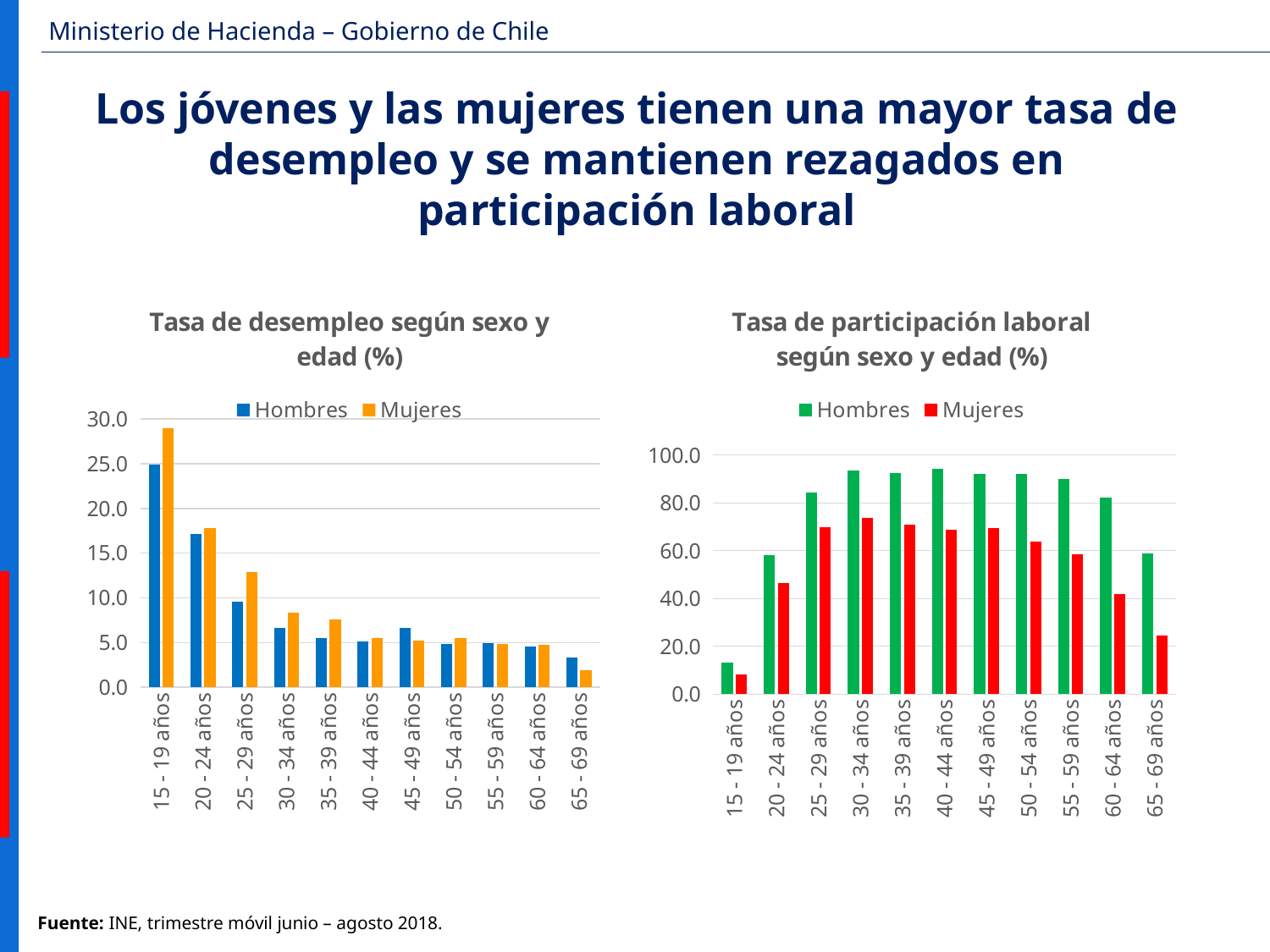
How many series does the legend list in the chart 'Tasa de participación laboral según sexo y edad (%)'? 2 In the chart 'Tasa de participación laboral según sexo y edad (%)', which is larger for the 50 - 54 años group, Hombres or Mujeres? Hombres How many age groups are shown on the x axis of the chart 'Tasa de desempleo según sexo y edad (%)'? 11 In the chart 'Tasa de desempleo según sexo y edad (%)', which is larger for the 25 - 29 años group, Hombres or Mujeres? Mujeres What kind of chart is 'Tasa de participación laboral según sexo y edad (%)'? Bar chart In the chart 'Tasa de participación laboral según sexo y edad (%)', which age group has the lowest participation rate for Hombres? 15 - 19 años In the chart 'Tasa de desempleo según sexo y edad (%)', is the value for Mujeres in the 15 - 19 años group greater or less than 25.0? greater In the chart 'Tasa de desempleo según sexo y edad (%)', which age group has the highest unemployment rate for Mujeres? 15 - 19 años In the chart 'Tasa de desempleo según sexo y edad (%)', which age group has the lowest unemployment rate for Mujeres? 65 - 69 años